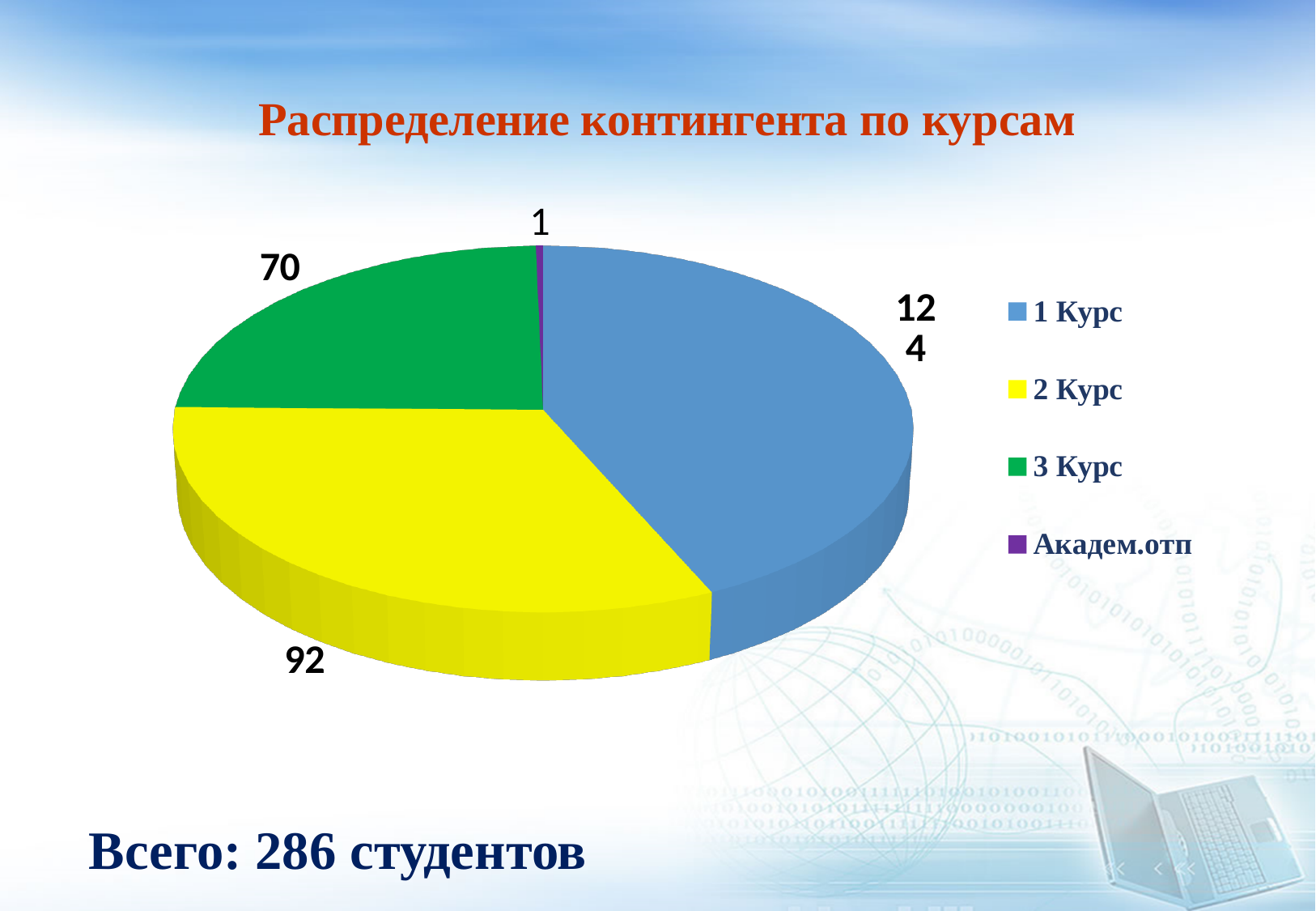
Which category has the largest slice of the pie? 1 Курс What is the difference between the values for 1 Курс and 2 Курс? 32 What is the value for 1 Курс? 124 What is the title of the chart? Распределение контингента по курсам What is the value for 2 Курс? 92 Which category has the smallest slice of the pie? Академ.отп What is the value for 3 Курс? 70 Which is larger, the value for 2 Курс or the value for 3 Курс? 2 Курс What is the value for Академ.отп? 1 What kind of chart is shown on the slide? Pie chart What is the difference between the values for 2 Курс and 3 Курс? 22 How many categories does the pie chart have? 4